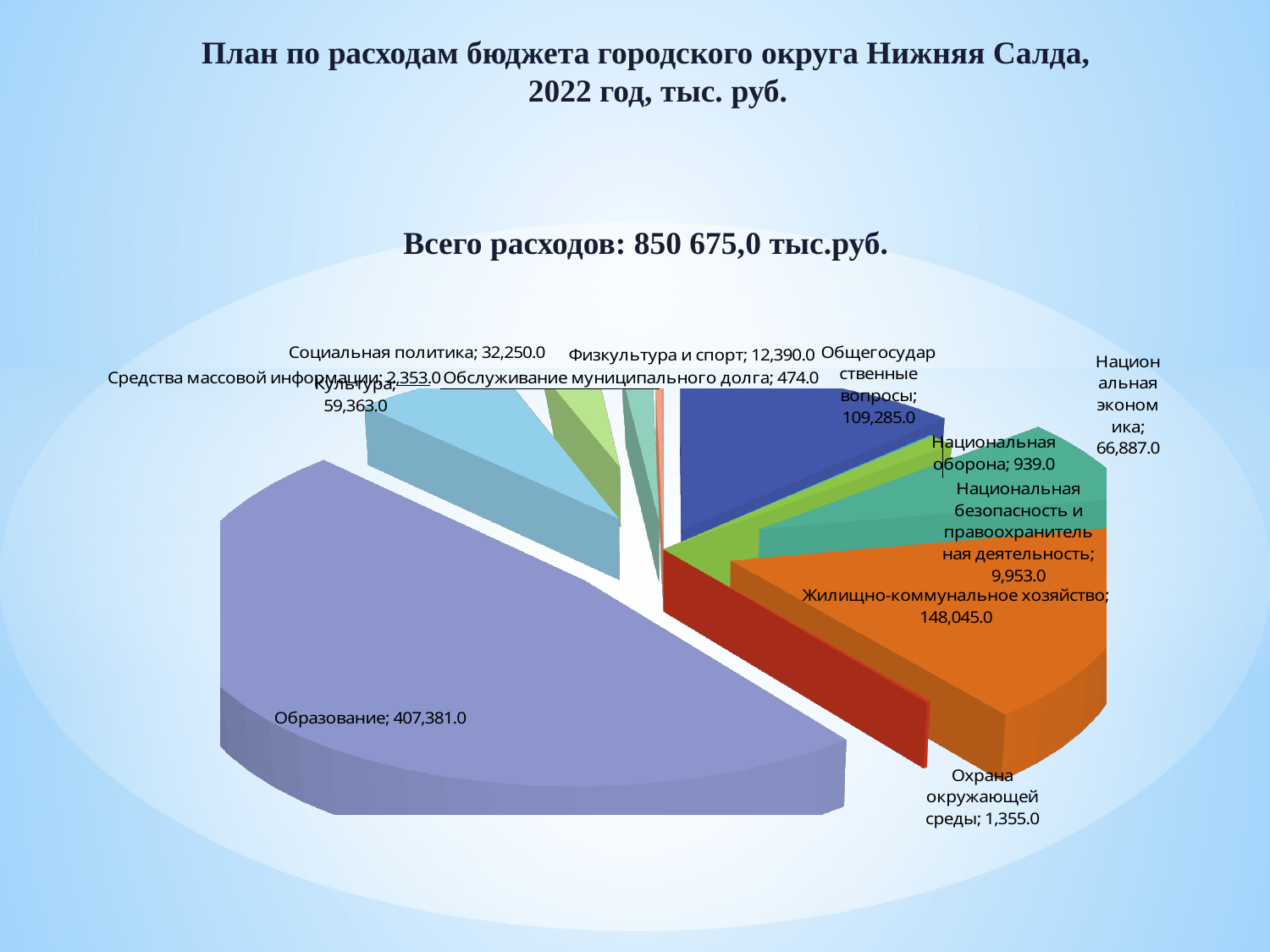
What is the value for Национальная оборона? 939.0 What is the difference between the values for Жилищно-коммунальное хозяйство and Общегосударственные вопросы? 38,760.0 How many categories are shown in the pie chart? 12 Which is larger, the value for Культура or the value for Национальная экономика? Национальная экономика Which category has the largest slice of the pie? Образование What kind of chart is shown on the slide? Pie chart What is the value for Физкультура и спорт? 12,390.0 Which category has the smallest value? Обслуживание муниципального долга What is the value for Жилищно-коммунальное хозяйство? 148,045.0 What is the value for Образование? 407,381.0 What is the value for Общегосударственные вопросы? 109,285.0 What total expenditure amount is stated on the slide? 850 675,0 тыс.руб.